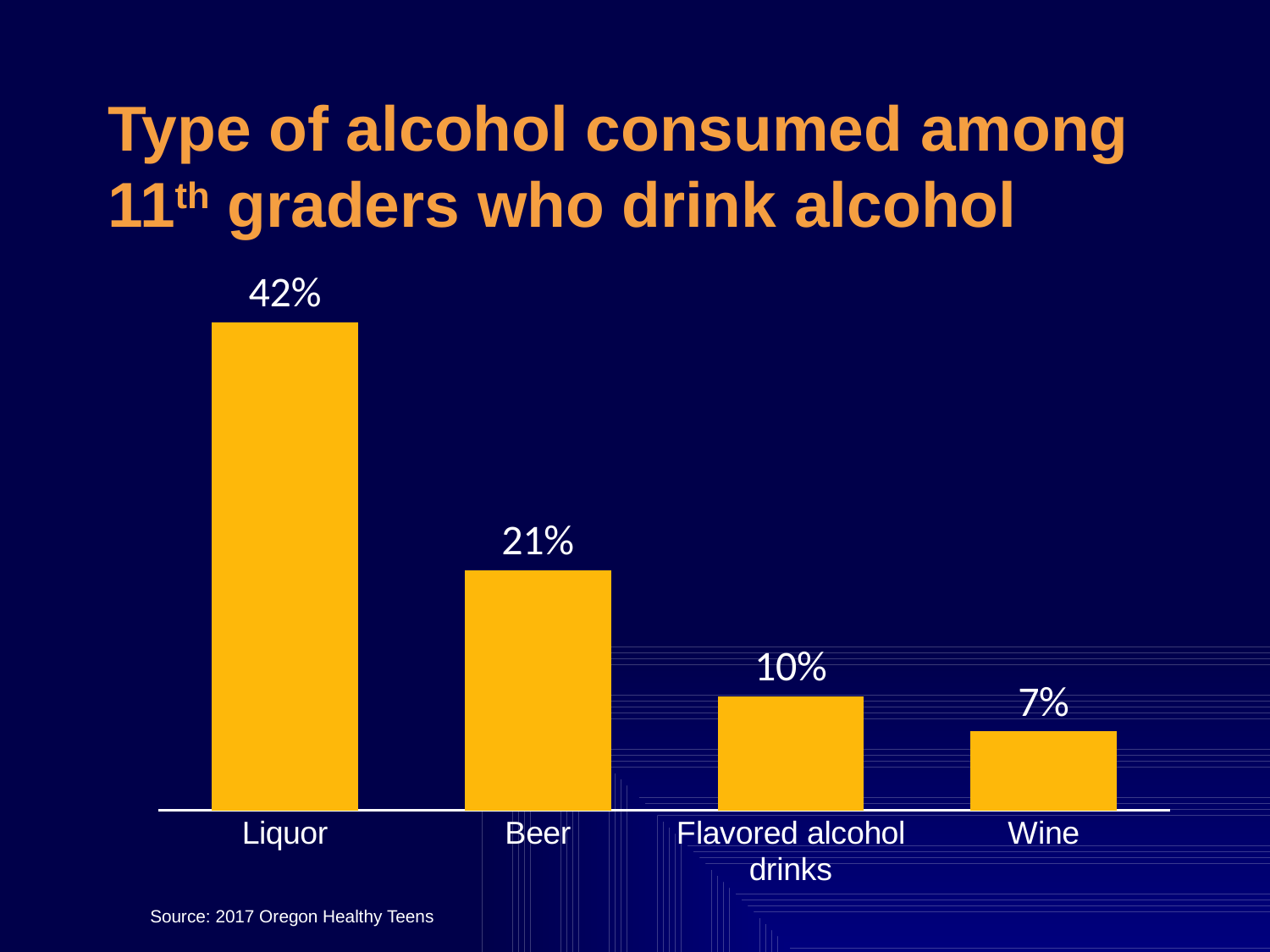
What is the value shown for Wine? 7% What is the difference between the values for Flavored alcohol drinks and Wine? 3% Which type of alcohol has the lowest value? Wine What is the value shown for Beer? 21% Which type of alcohol has the highest value? Liquor What is the difference between the values for Liquor and Beer? 21% What is the value shown for Flavored alcohol drinks? 10% Which is larger, the value for Beer or the value for Flavored alcohol drinks? Beer What is the source cited for the chart data? 2017 Oregon Healthy Teens What percentage of 11th graders who drink alcohol consume liquor? 42% What kind of chart is shown on the slide? Bar chart How many types of alcohol are shown on the chart? 4